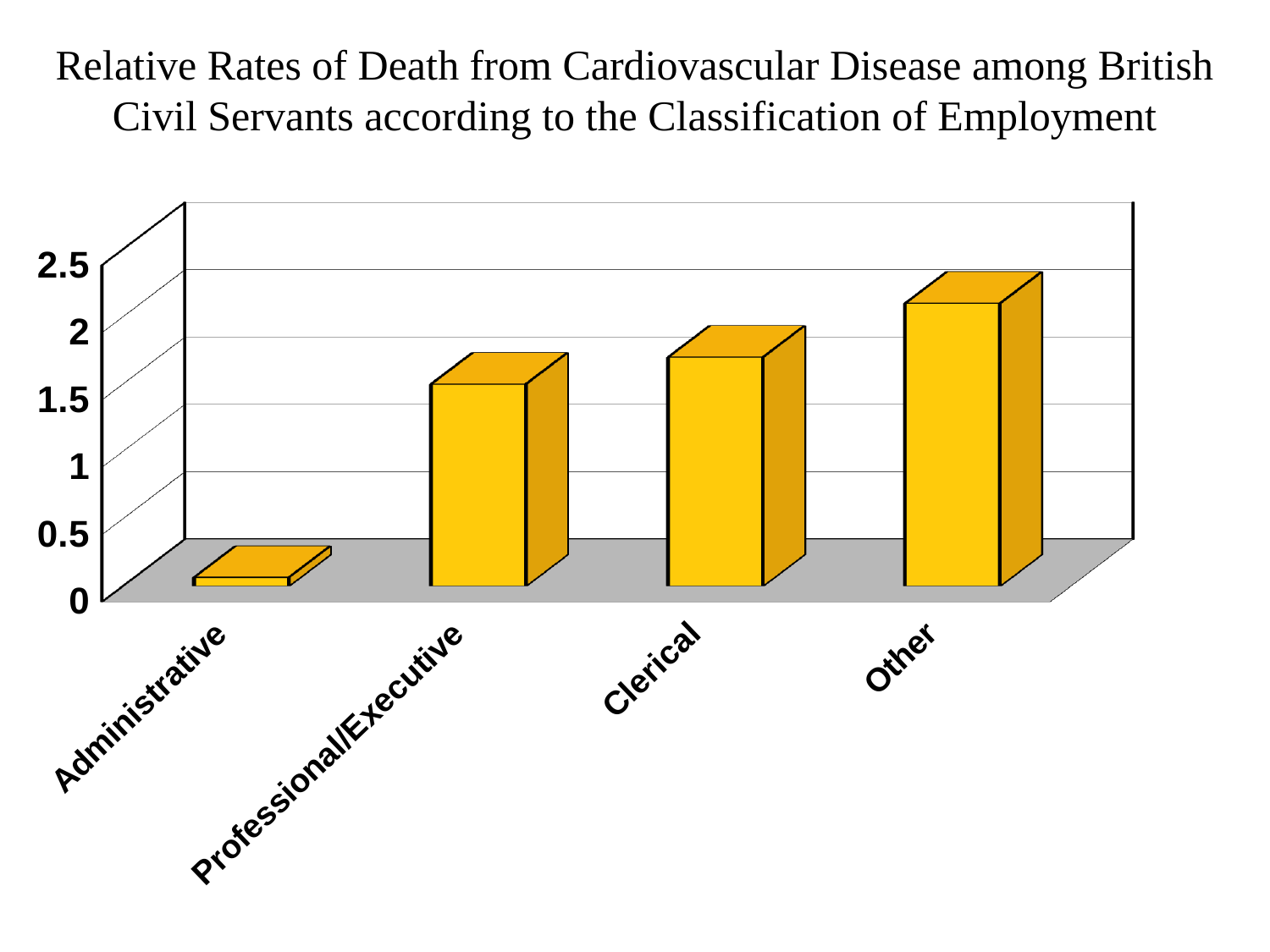
Is the value for Administrative greater or less than 0.5? less Which employment category has the highest relative rate of death from cardiovascular disease? Other What colour are the bars in the chart? yellow Is the value for Clerical greater or less than 2.5? less Is the value for Professional/Executive greater or less than 1? greater Do the values rise or fall moving from Administrative to Other along the x axis? rise How many employment categories are shown on the chart? 4 Which is larger, the value for Other or the value for Administrative? Other Which employment category has the lowest relative rate of death from cardiovascular disease? Administrative What kind of chart is shown on the slide? bar chart Which is larger, the value for Clerical or the value for Professional/Executive? Clerical